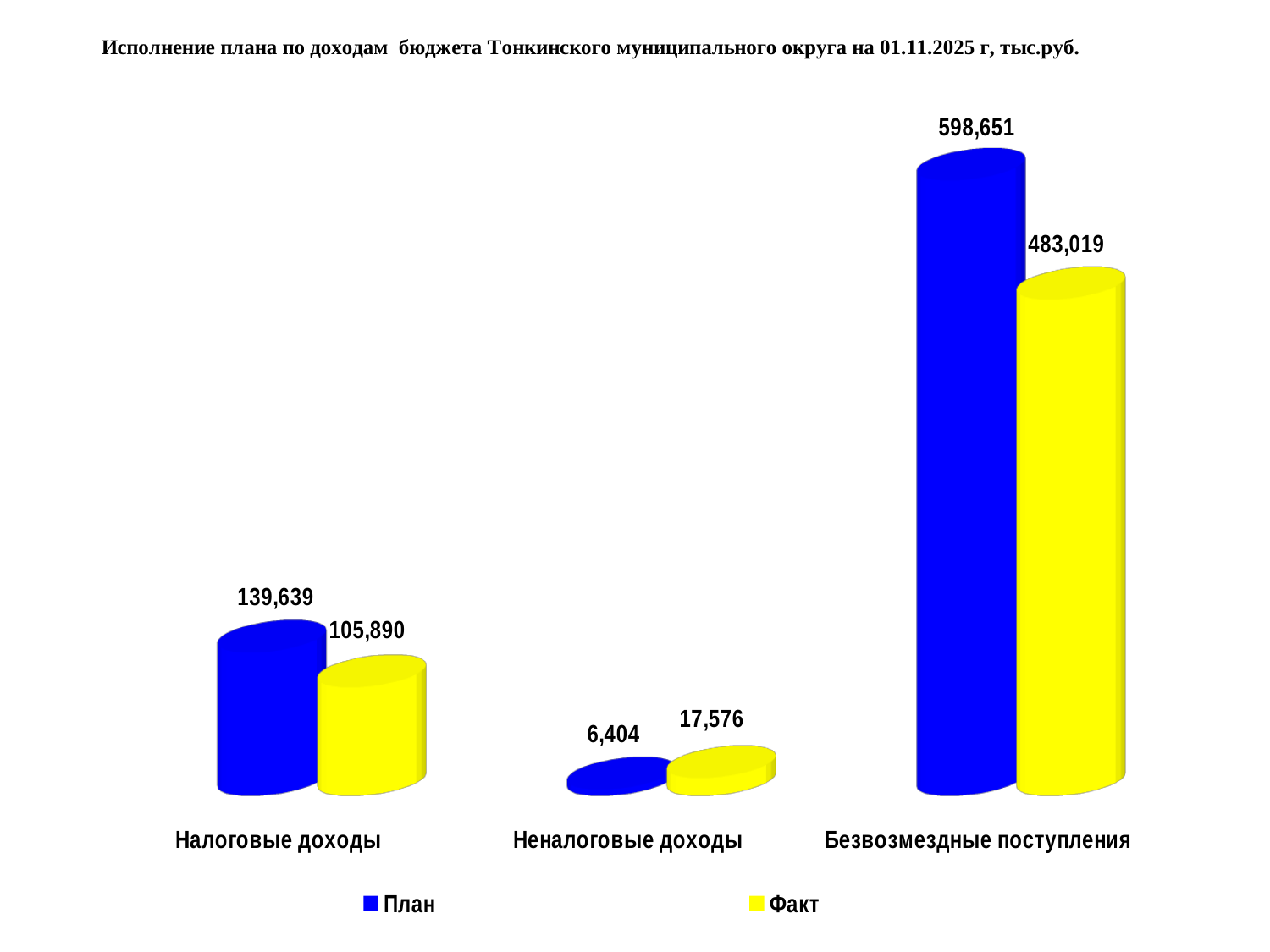
What is the Факт value for Неналоговые доходы? 17,576 How many categories are shown on the x axis? 3 What is the difference between the План and Факт values for Безвозмездные поступления? 115,632 Which category has the highest План value? Безвозмездные поступления Which colour represents the Факт series? Yellow Which category has the lowest Факт value? Неналоговые доходы For Неналоговые доходы, which is larger: План or Факт? Факт What is the difference between the План and Факт values for Налоговые доходы? 33,749 How many series does the legend list? 2 What kind of chart is shown on the slide? Bar chart What is the План value for Налоговые доходы? 139,639 What is the Факт value for Безвозмездные поступления? 483,019